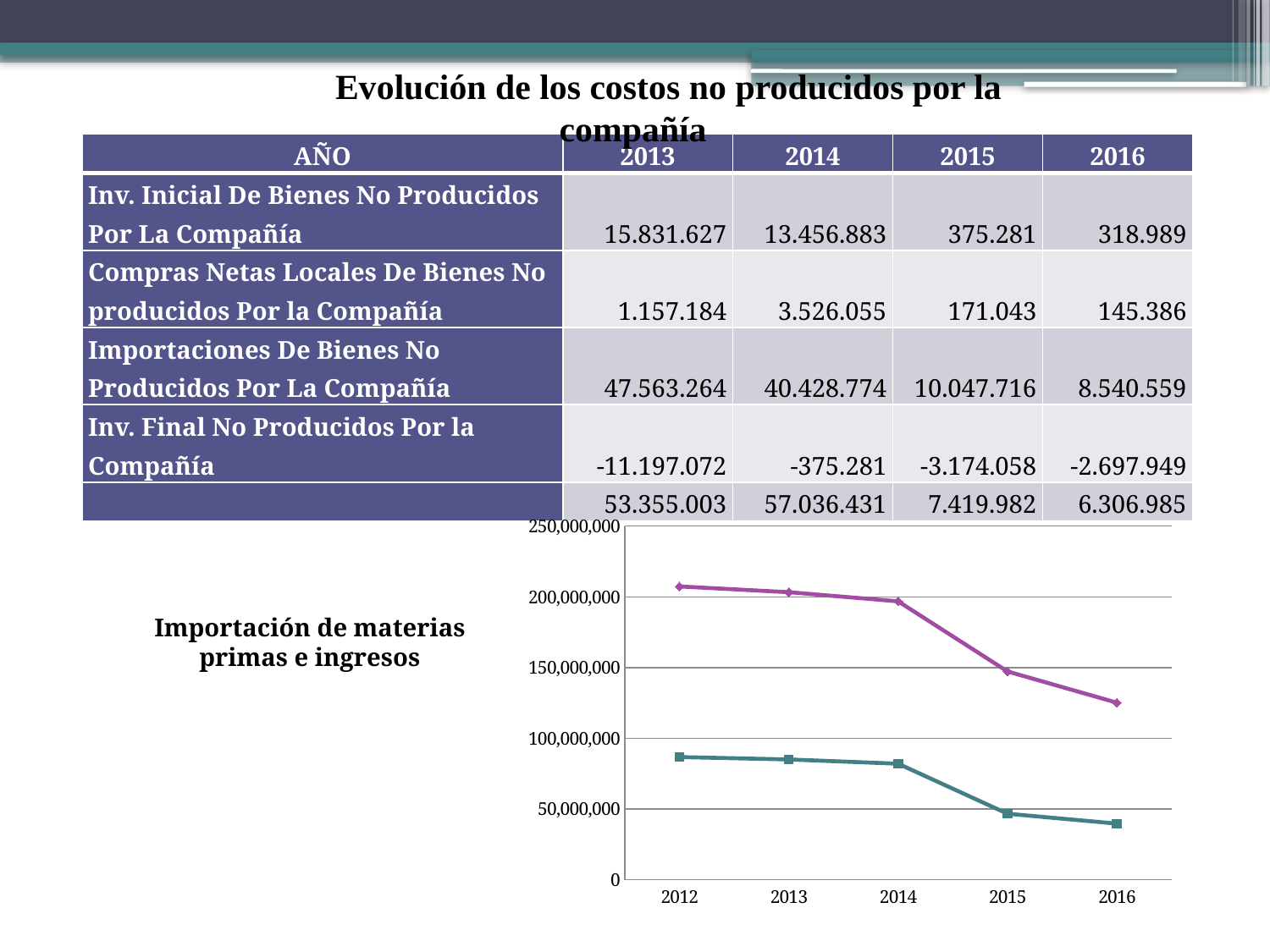
In the line chart, which line has the larger value in 2014, the purple line or the teal line? the purple line In the line chart, is the value of the teal line in 2016 greater or less than 50,000,000? less In the line chart, do the values of the teal line rise or fall from 2012 to 2016? fall How many lines (series) are plotted in the line chart? 2 In the line chart, is the value of the teal line in 2012 greater or less than 100,000,000? less In the line chart, is the value of the purple line in 2012 greater or less than 200,000,000? greater How many years are plotted along the x axis of the line chart? 5 In the line chart, which year has the lowest value for the teal line? 2016 In the line chart, which year has the highest value for the purple line? 2012 In the line chart, do the values of the purple line rise or fall from 2012 to 2016? fall What kind of chart is shown at the bottom right of the slide? line chart